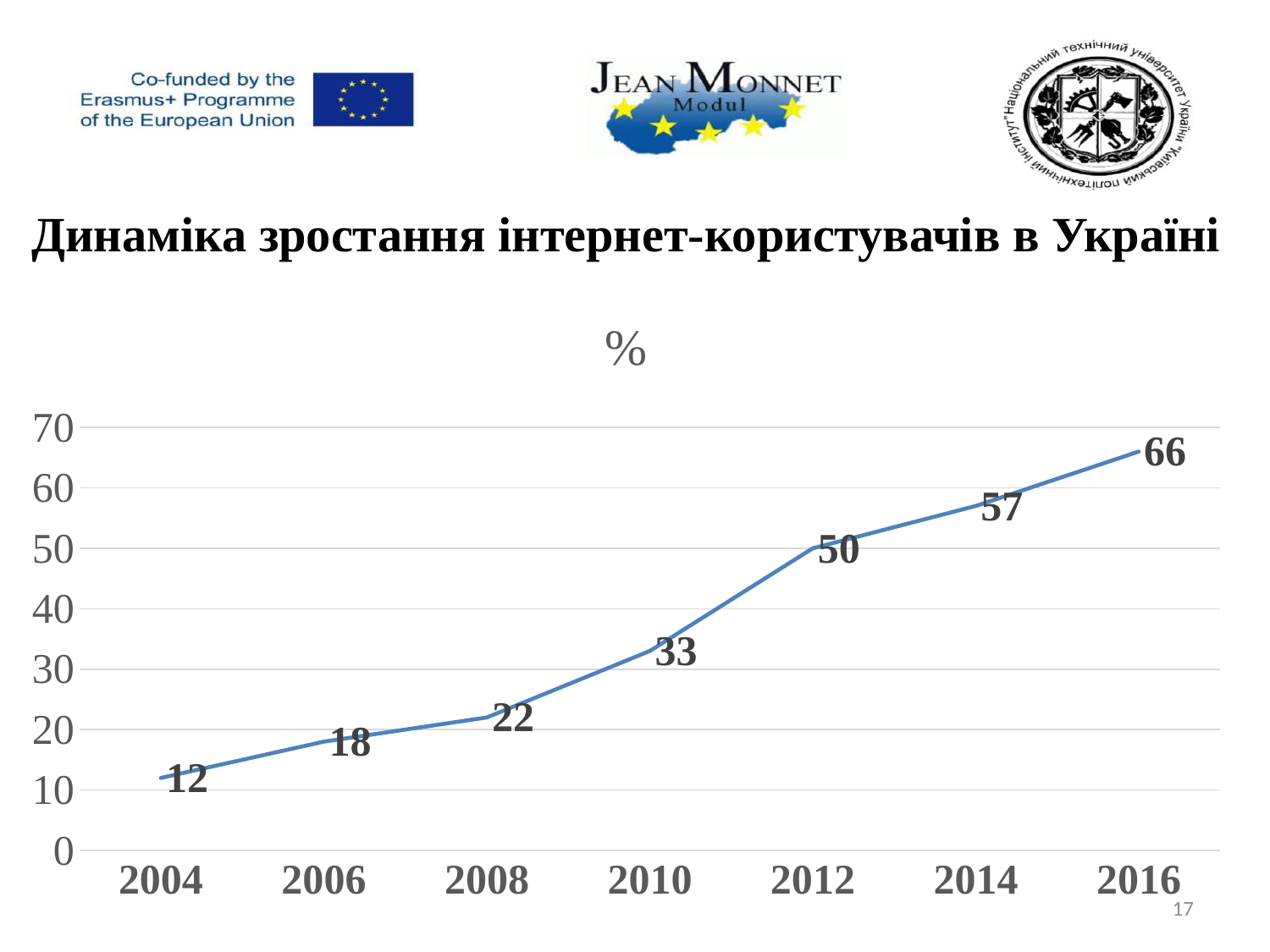
What is the difference between the values for 2012 and 2010? 17 What kind of chart is shown on the slide? line chart How many data points are plotted on the chart? 7 What value is shown for 2010? 33 What value is shown for 2014? 57 What value is shown for 2004? 12 Do the values rise or fall from 2004 to 2016? rise What is the difference between the values for 2016 and 2004? 54 Which is larger, the value for 2008 or the value for 2012? 2012 Which year has the highest value? 2016 Which year has the lowest value? 2004 Is the value for 2014 greater or less than 50? greater